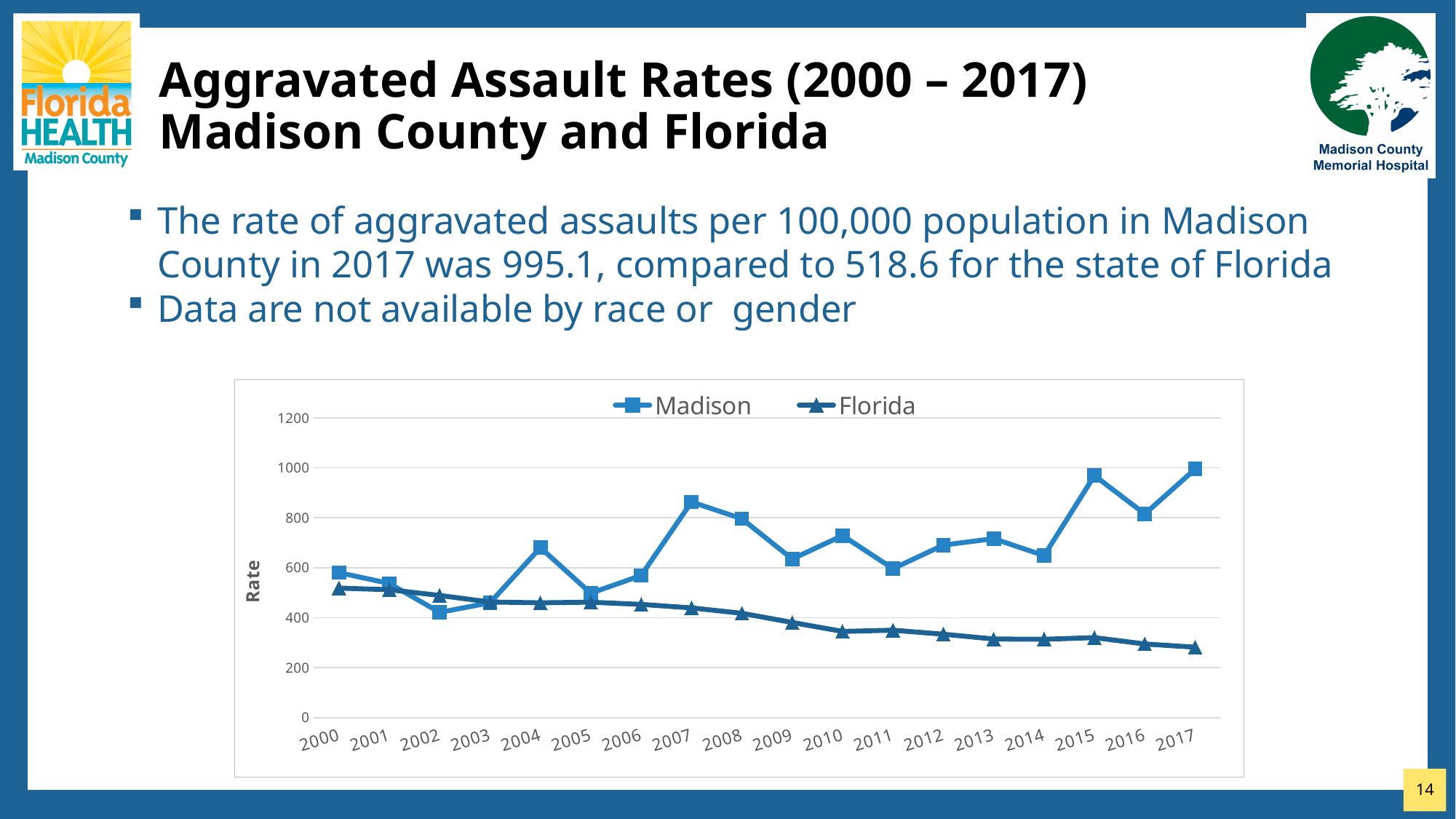
What was the aggravated assault rate for Madison County in 2017? 995.1 What is the label on the vertical axis of the chart? Rate Is the value for Madison in 2015 greater or less than 800? greater Which two series are listed in the chart legend? Madison and Florida How many series does the chart legend list? 2 In 2017, which series has the higher value, Madison or Florida? Madison Is the value for Florida in 2017 greater or less than 400? less Does the Florida series generally rise or fall from 2000 to 2017? fall How many years are plotted along the x axis of the chart? 18 Is the value for Madison in 2002 greater or less than 600? less What kind of chart is shown on the slide? line chart